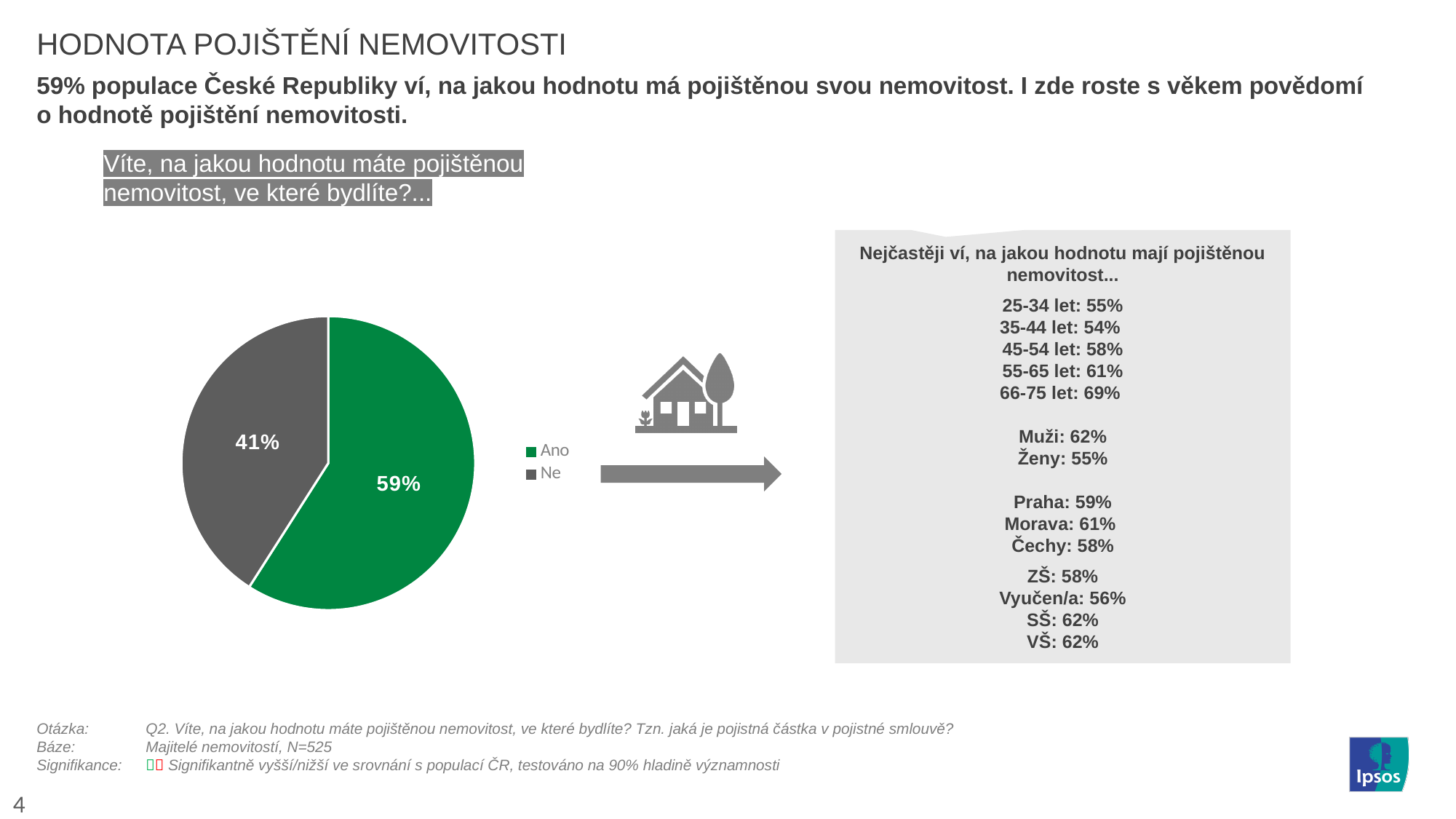
What share of the pie chart is labelled "Ne"? 41% Which is larger in the pie chart, "Ano" or "Ne"? Ano What colour is the "Ano" slice in the pie chart? green How many entries does the legend of the pie chart list? 2 What is the difference in percentage points between the "Ano" and "Ne" slices? 18 What colour is the "Ne" slice in the pie chart? grey Which slice of the pie chart is the smallest? Ne How many slices does the pie chart have? 2 What kind of chart is shown on the slide? pie chart Is the "Ano" share in the pie chart greater or less than 50%? greater What share of the pie chart is labelled "Ano"? 59% Which slice of the pie chart is the largest? Ano